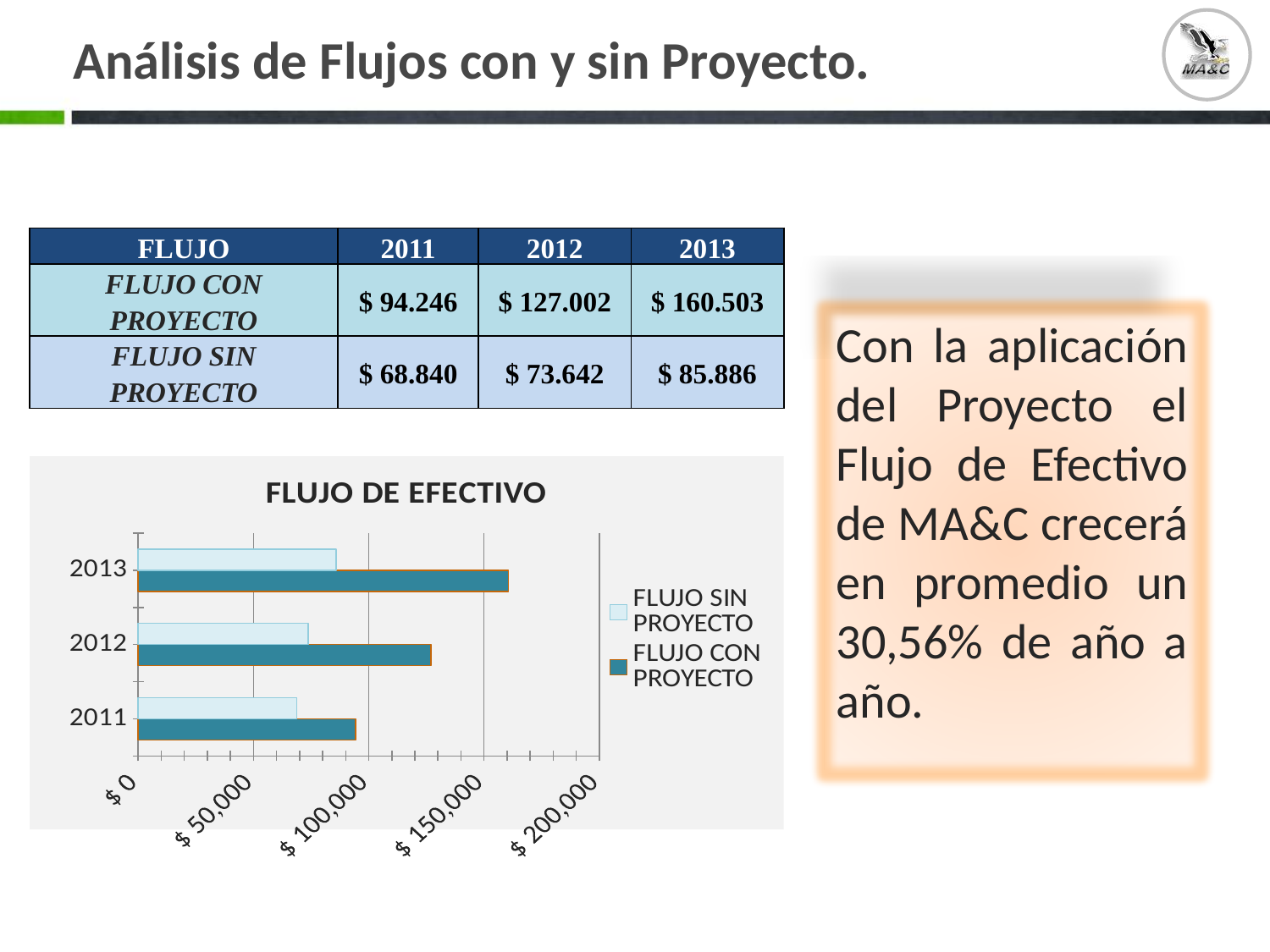
Using the table values on the slide, what is the difference between FLUJO CON PROYECTO and FLUJO SIN PROYECTO in 2013? $ 74.617 In the FLUJO DE EFECTIVO chart, which is larger for 2012: FLUJO CON PROYECTO or FLUJO SIN PROYECTO? FLUJO CON PROYECTO In the FLUJO DE EFECTIVO chart, is the FLUJO SIN PROYECTO value for 2011 greater or less than $ 100,000? less How many series does the legend of the FLUJO DE EFECTIVO chart list? 2 In the FLUJO DE EFECTIVO chart, which year has the lowest FLUJO SIN PROYECTO bar? 2011 In the FLUJO DE EFECTIVO chart, is the FLUJO CON PROYECTO value for 2013 greater or less than $ 150,000? greater How many years are shown on the vertical axis of the FLUJO DE EFECTIVO chart? 3 In the FLUJO DE EFECTIVO chart, which year has the highest FLUJO CON PROYECTO bar? 2013 In the FLUJO DE EFECTIVO chart, does FLUJO CON PROYECTO rise or fall from 2011 to 2013? Rise In the FLUJO DE EFECTIVO chart, is the FLUJO CON PROYECTO value for 2012 greater or less than $ 100,000? greater According to the table on the slide, what is the FLUJO CON PROYECTO value for 2012? $ 127.002 What kind of chart is shown under the title FLUJO DE EFECTIVO? Bar chart